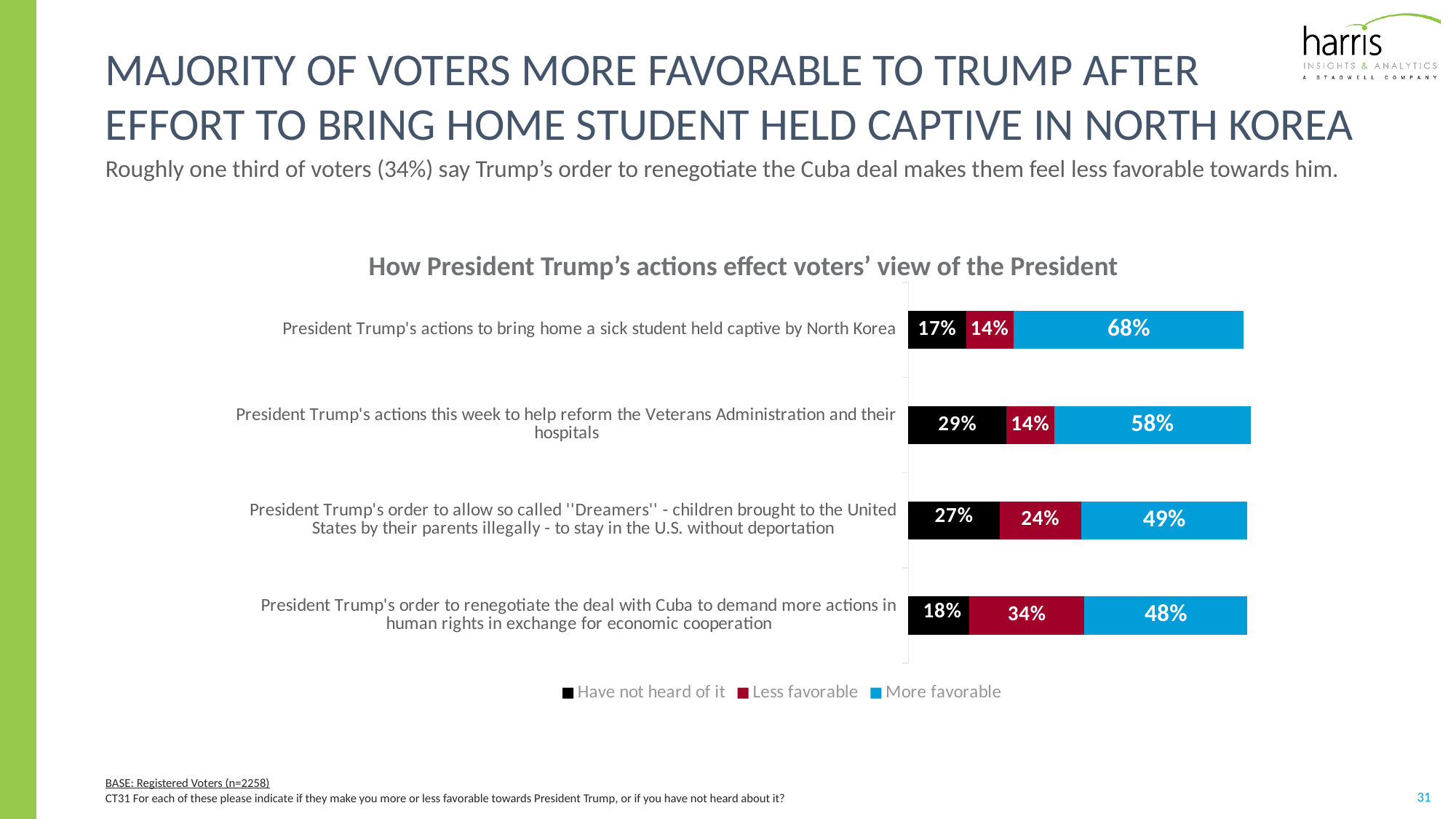
Which is larger: the 'Less favorable' share for the Dreamers order or for the Cuba deal order? The Cuba deal order (34%) Which action has the lowest 'Less favorable' percentage? Tied: the North Korea student action and the Veterans Administration reform, both 14% Which action has the highest 'More favorable' percentage? President Trump's actions to bring home a sick student held captive by North Korea What is the difference between the 'More favorable' percentages for the Veterans Administration reform and the Dreamers order? 9 percentage points What percentage of voters say they are more favorable after President Trump's actions to bring home a sick student held captive by North Korea? 68% What percentage of voters have not heard of President Trump's actions to help reform the Veterans Administration and their hospitals? 29% What percentage of voters say they are less favorable after President Trump's order to renegotiate the deal with Cuba? 34% What is the total of the three segments for the Dreamers order bar? 100% How many actions (categories) are shown in the chart? 4 Which colour represents 'More favorable' in the chart? Blue How many series does the legend list? 3 What type of chart is shown on the slide? Stacked horizontal bar chart